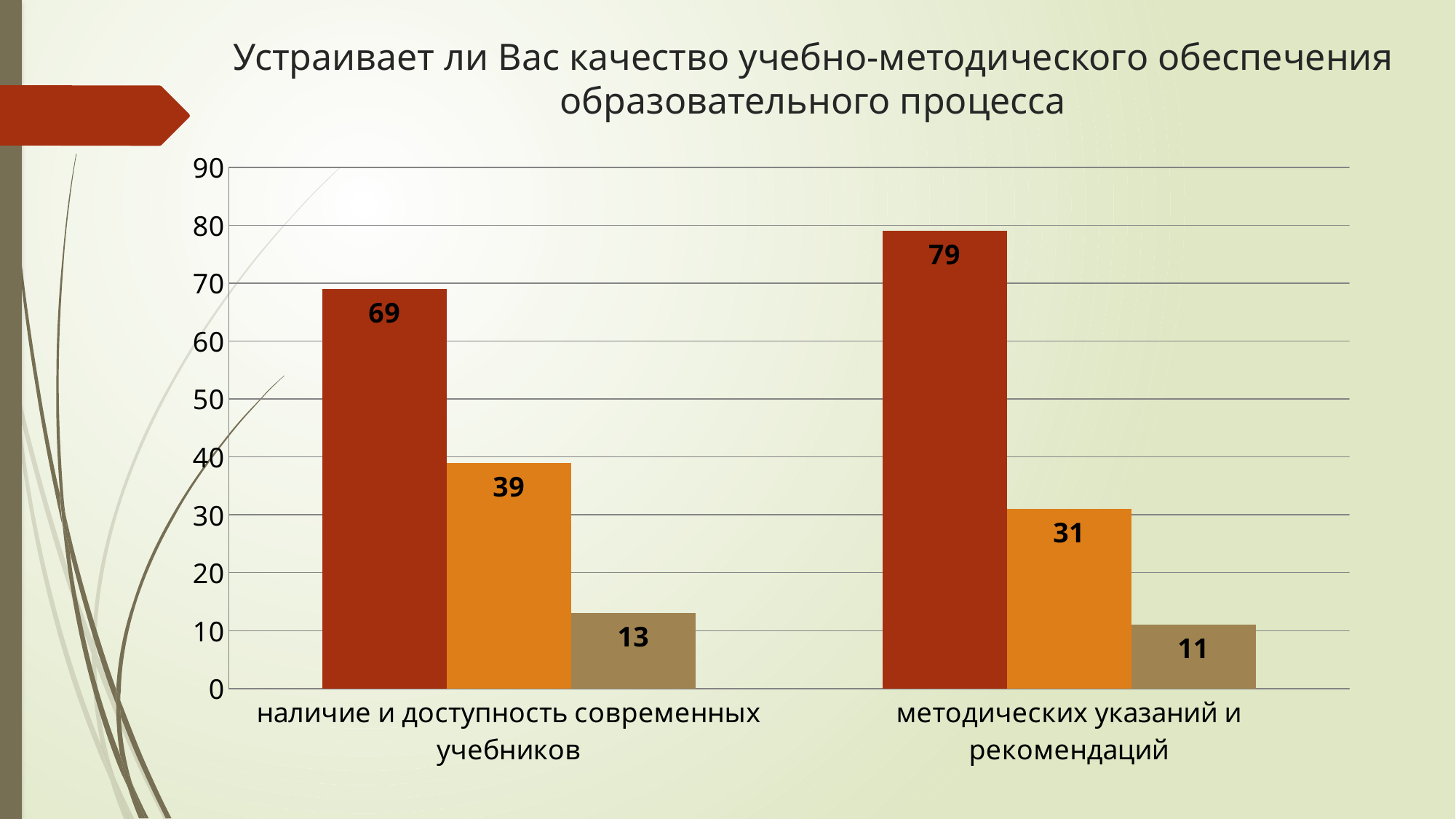
Which bar has the highest value on the chart? The dark red bar for "методических указаний и рекомендаций" (79) What is the difference between the orange bar and the tan bar for "наличие и доступность современных учебников"? 26 What is the title of the chart? Устраивает ли Вас качество учебно-методического обеспечения образовательного процесса What is the value of the tan bar for "наличие и доступность современных учебников"? 13 What is the value of the dark red bar for "наличие и доступность современных учебников"? 69 How many categories are shown on the x axis? 2 Which is larger: the orange bar for "наличие и доступность современных учебников" or the orange bar for "методических указаний и рекомендаций"? наличие и доступность современных учебников What kind of chart is shown on the slide? Bar chart Which bar has the lowest value on the chart? The tan bar for "методических указаний и рекомендаций" (11) What is the value of the dark red bar for "методических указаний и рекомендаций"? 79 What is the difference between the dark red bars of the two categories? 10 What is the value of the orange bar for "методических указаний и рекомендаций"? 31